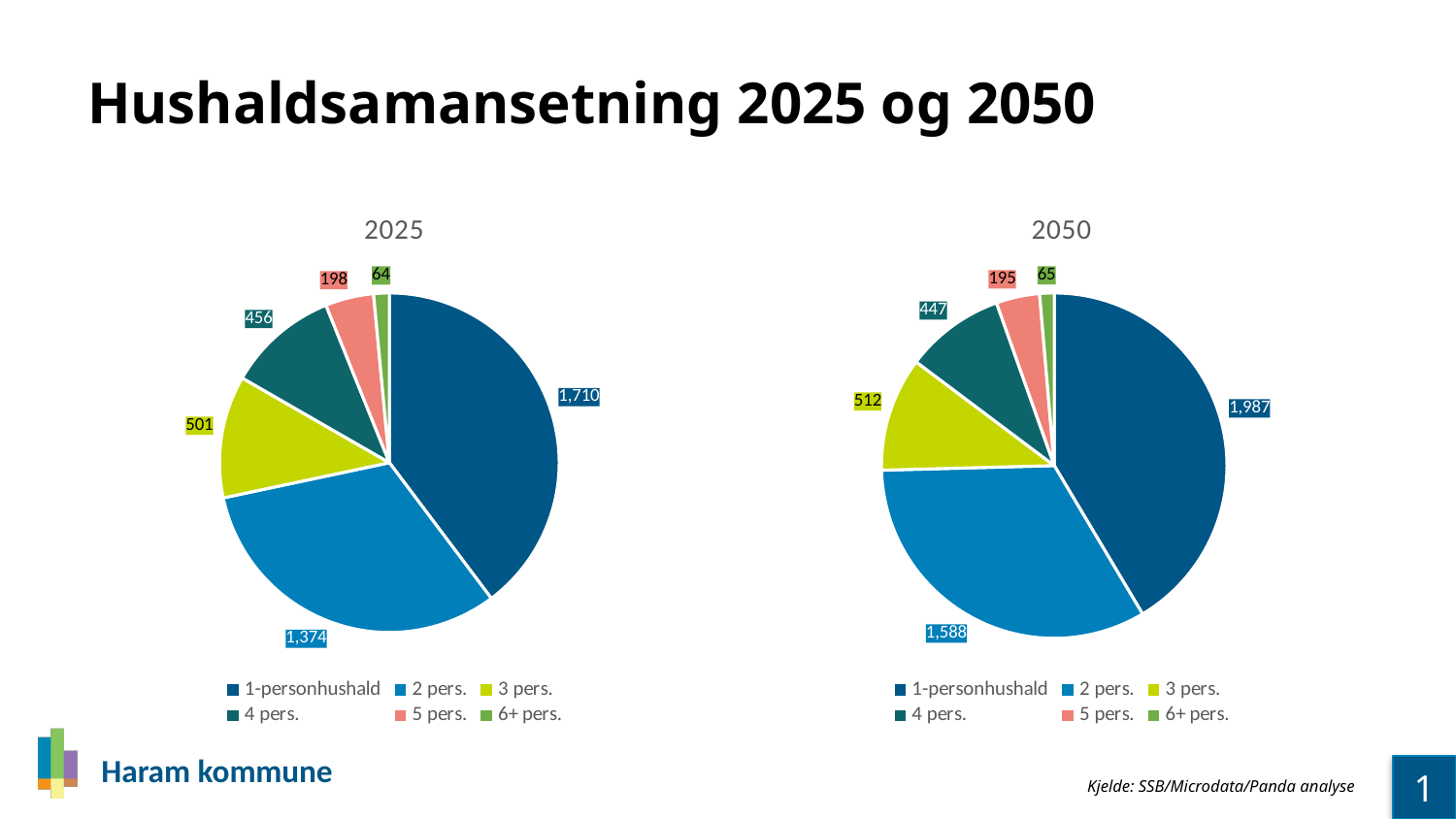
In the 2050 pie chart, what is the value for 2 pers.? 1,588 Is the value for 3 pers. larger in the 2025 chart or the 2050 chart? 2050 What is the difference between the 1-personhushald value in the 2050 chart and in the 2025 chart? 277 In the 2025 pie chart, what is the value for 4 pers.? 456 In the 2025 pie chart, what is the value for 1-personhushald? 1,710 What type of chart is used for the 2050 data? Pie chart How many categories does the 2025 pie chart show? 6 In the 2050 pie chart, what is the value for 6+ pers.? 65 In the 2025 pie chart, what is the difference between the values for 1-personhushald and 2 pers.? 336 In the 2050 pie chart, which category has the largest slice? 1-personhushald What is the title of the slide? Hushaldsamansetning 2025 og 2050 In the 2025 pie chart, which category has the smallest slice? 6+ pers.